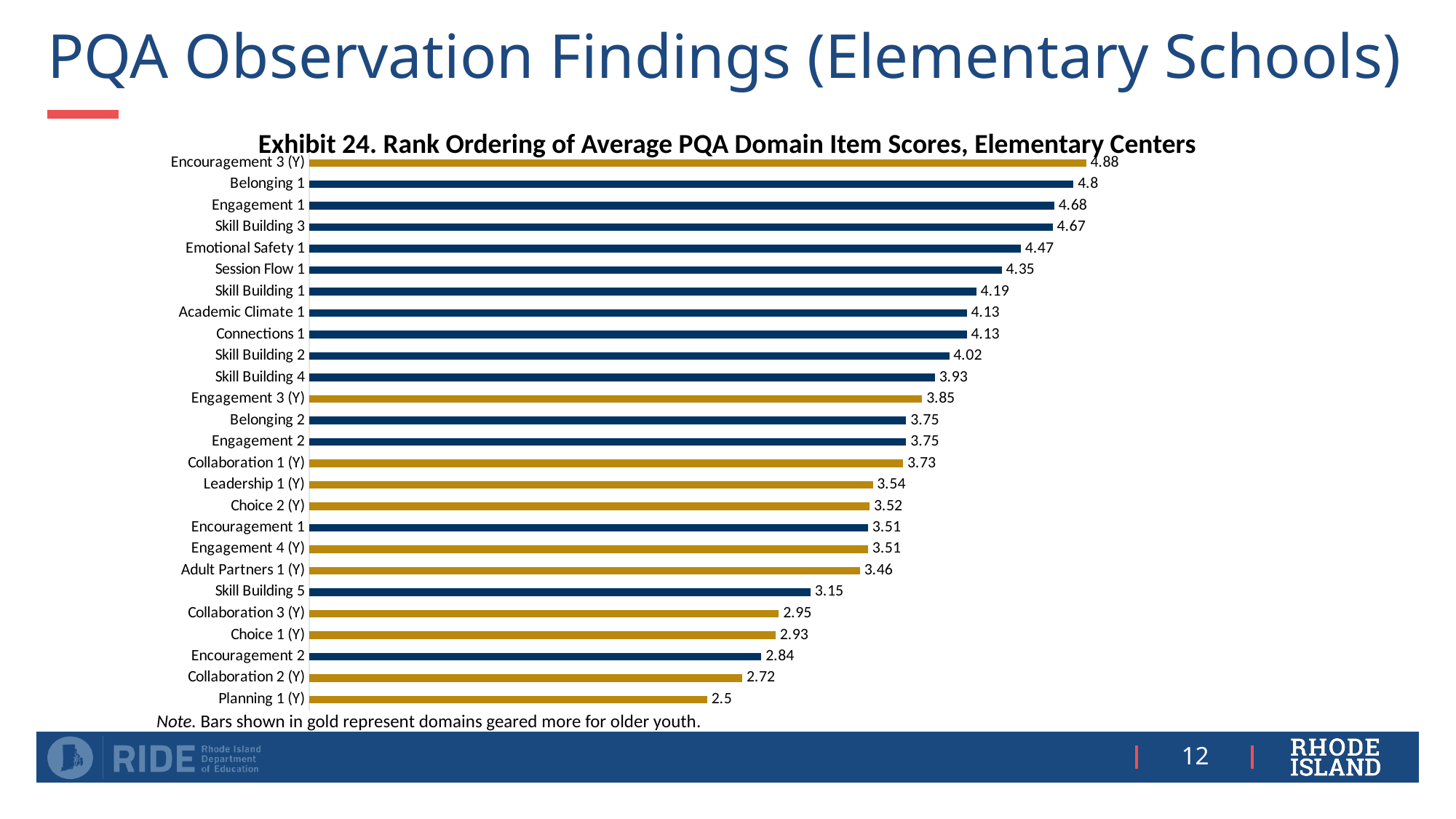
What is the difference between the scores for Belonging 1 and Belonging 2? 1.05 According to the note, what do the gold bars represent? Domains geared more for older youth Which item has the highest average score? Encouragement 3 (Y) Which item has the lowest average score? Planning 1 (Y) How many items are shown in the chart? 26 What type of chart is shown on the slide? Bar chart What is the average score for Adult Partners 1 (Y)? 3.46 What is the average score for Emotional Safety 1? 4.47 Which has a higher score, Session Flow 1 or Skill Building 1? Session Flow 1 What is the average score for Skill Building 5? 3.15 What is the difference between the scores for Encouragement 3 (Y) and Planning 1 (Y)? 2.38 Which has a higher score, Choice 1 (Y) or Encouragement 2? Choice 1 (Y)